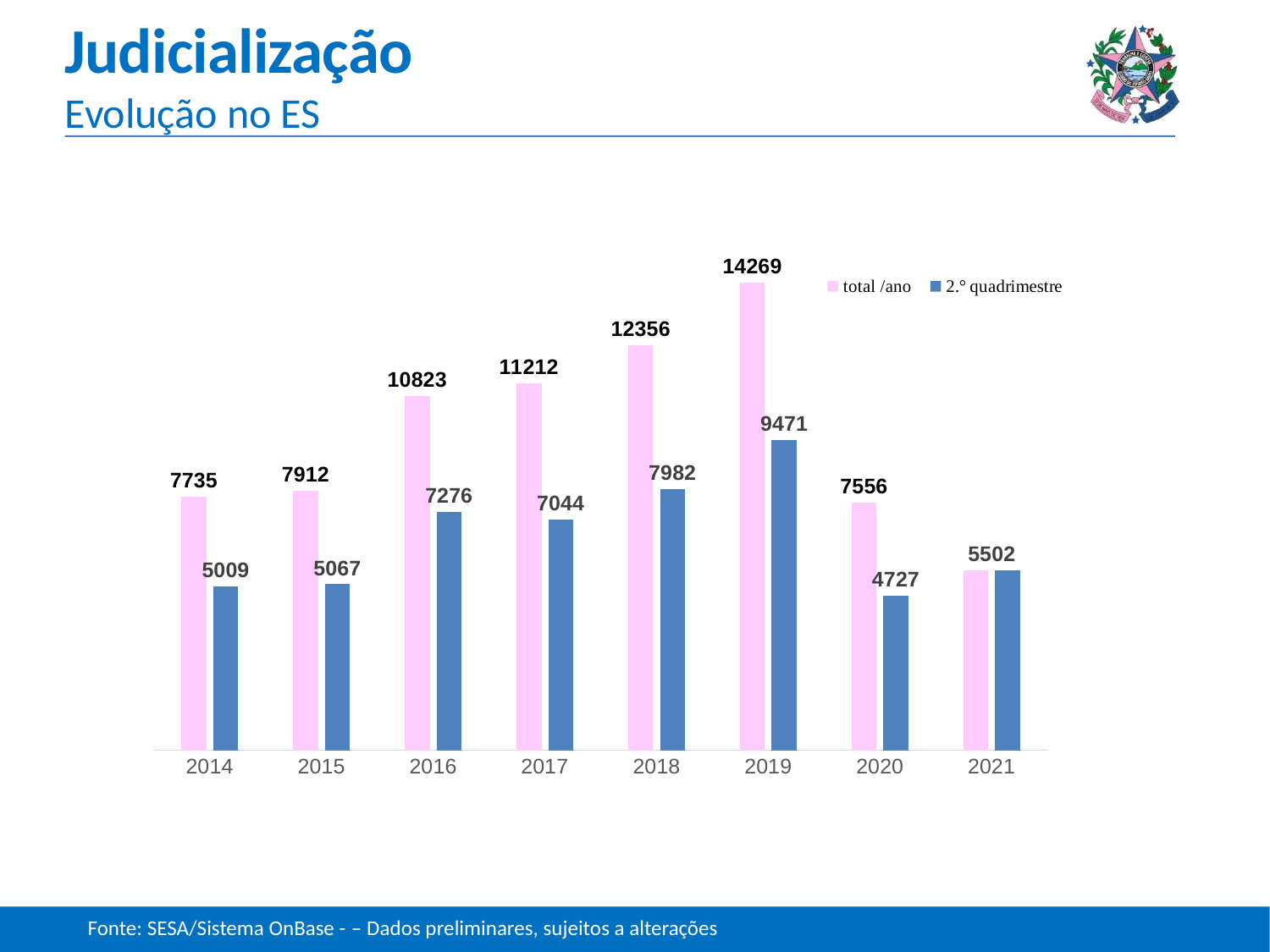
What is the value of "2.° quadrimestre" for 2016? 7276 How many years are shown on the x axis? 8 How many series does the legend list? 2 What is the difference between "total /ano" and "2.° quadrimestre" in 2018? 4374 Which year has the highest "total /ano" value? 2019 Which colour represents the "2.° quadrimestre" series? blue What is the value of "total /ano" for 2019? 14269 Which year has the lowest "2.° quadrimestre" value? 2020 Does the "total /ano" value rise or fall from 2014 to 2019? rise Which is larger: the "total /ano" value for 2017 or for 2016? 2017 What is the value of "2.° quadrimestre" for 2021? 5502 What kind of chart is shown on the slide? bar chart